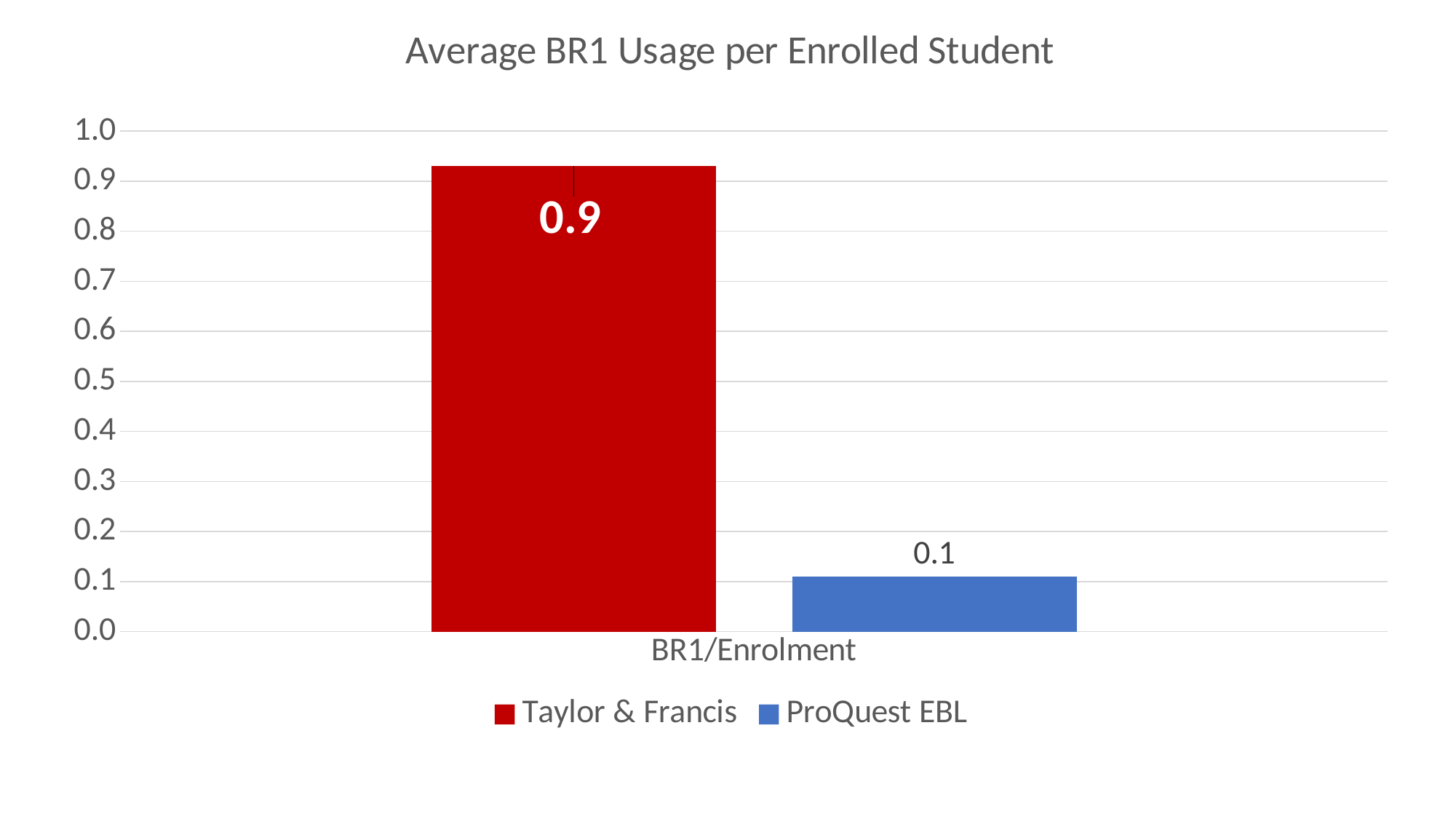
What is the value for Taylor & Francis? 0.9 Is the value for ProQuest EBL greater or less than 0.2? less Which series has the highest value? Taylor & Francis What is the title of the chart? Average BR1 Usage per Enrolled Student Which is larger, the value for Taylor & Francis or the value for ProQuest EBL? Taylor & Francis What is the difference between the Taylor & Francis value and the ProQuest EBL value? 0.8 What is the category label on the x axis? BR1/Enrolment What kind of chart is shown? bar chart What is the value for ProQuest EBL? 0.1 How many series does the legend list? 2 Which series has the lowest value? ProQuest EBL Is the value for Taylor & Francis greater or less than 0.5? greater